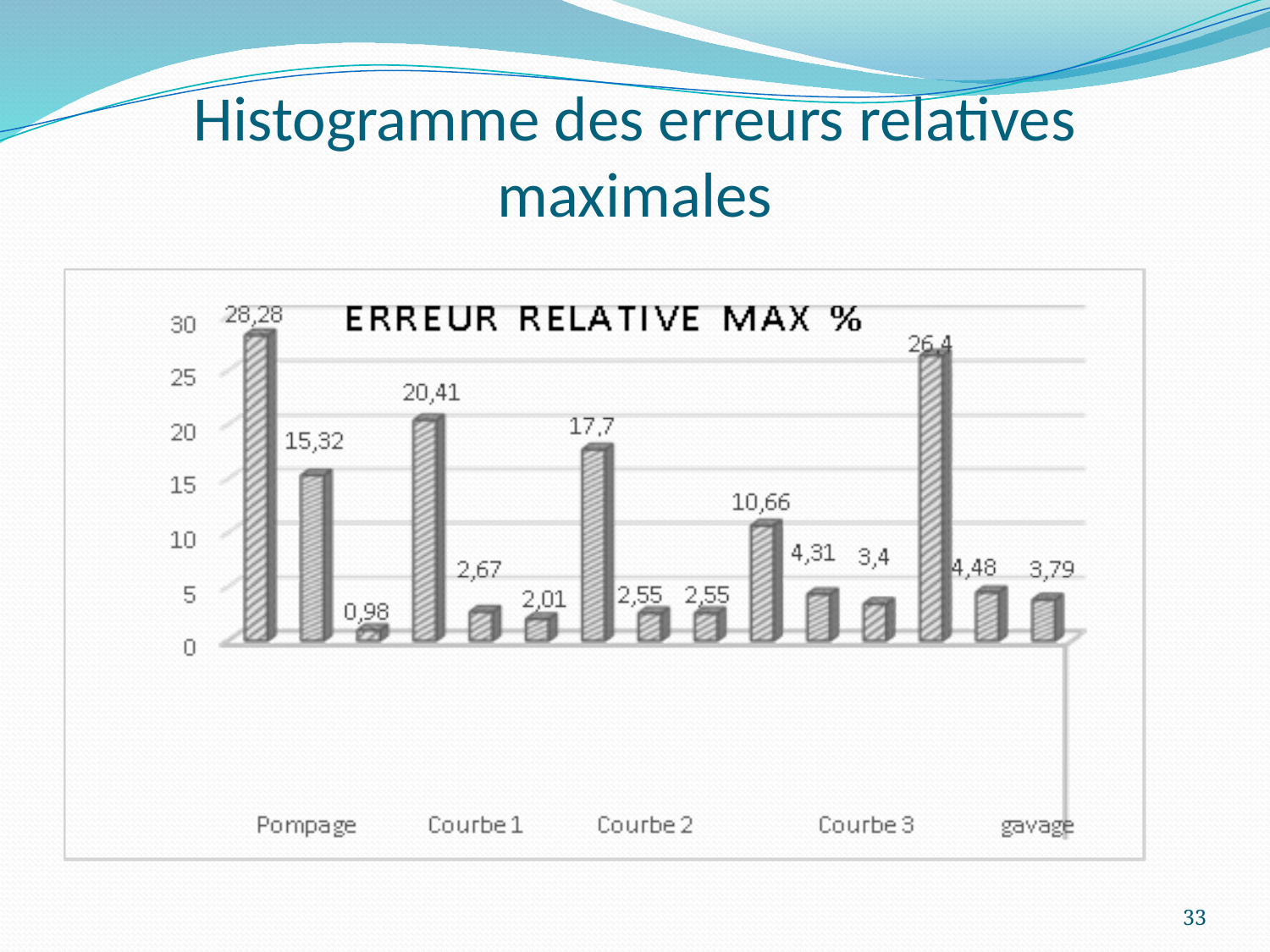
What is the difference between the tallest bar in the Pompage group (28,28) and the tallest bar in the gavage group (26,4)? 1,88 Is the tallest bar in the Courbe 3 group greater or less than 15? less What kind of chart is shown on the slide? bar chart What is the smallest value labelled in the Pompage group? 0,98 Which category contains the highest bar in the chart? Pompage What is the value of the tallest bar in the Courbe 2 group? 17,7 What is the value of the tallest bar in the Pompage group? 28,28 What is the value of the tallest bar in the gavage group? 26,4 Which is larger: the tallest bar in Courbe 1 or the tallest bar in Courbe 3? Courbe 1 Which category contains the lowest bar in the chart? Pompage What is the title of the chart? ERREUR RELATIVE MAX % How many categories are labelled on the x axis of the chart? 5